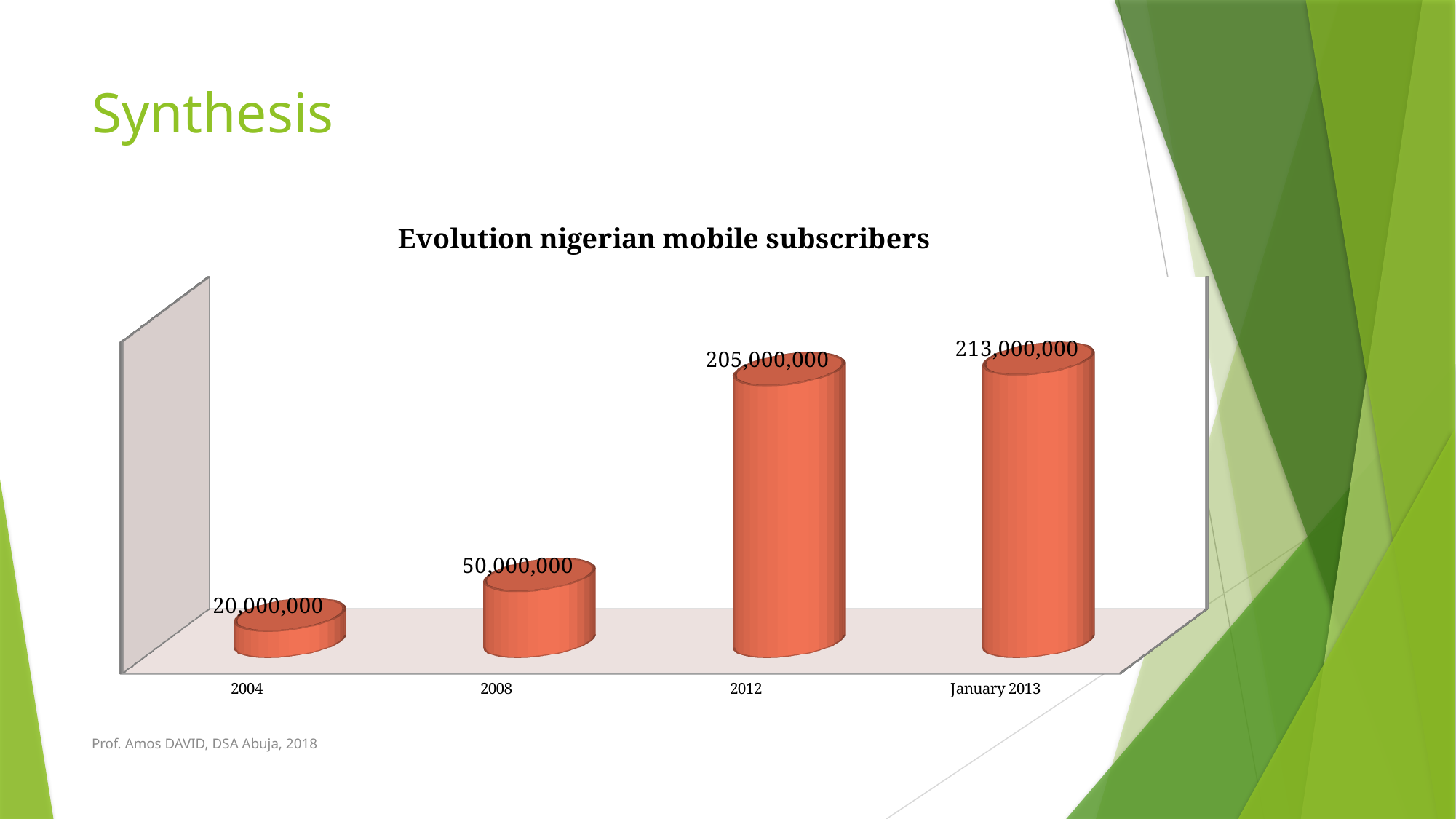
How many categories are shown on the x axis? 4 What kind of chart is this? bar chart What is the difference between the values for January 2013 and 2012? 8,000,000 Do the values rise or fall from 2004 to January 2013? rise What is the value for 2004? 20,000,000 What is the value for January 2013? 213,000,000 What is the difference between the values for 2008 and 2004? 30,000,000 Which category has the lowest value? 2004 What is the value for 2012? 205,000,000 What is the value for 2008? 50,000,000 Which category has the highest value? January 2013 Which is larger, the value for 2008 or the value for 2012? 2012